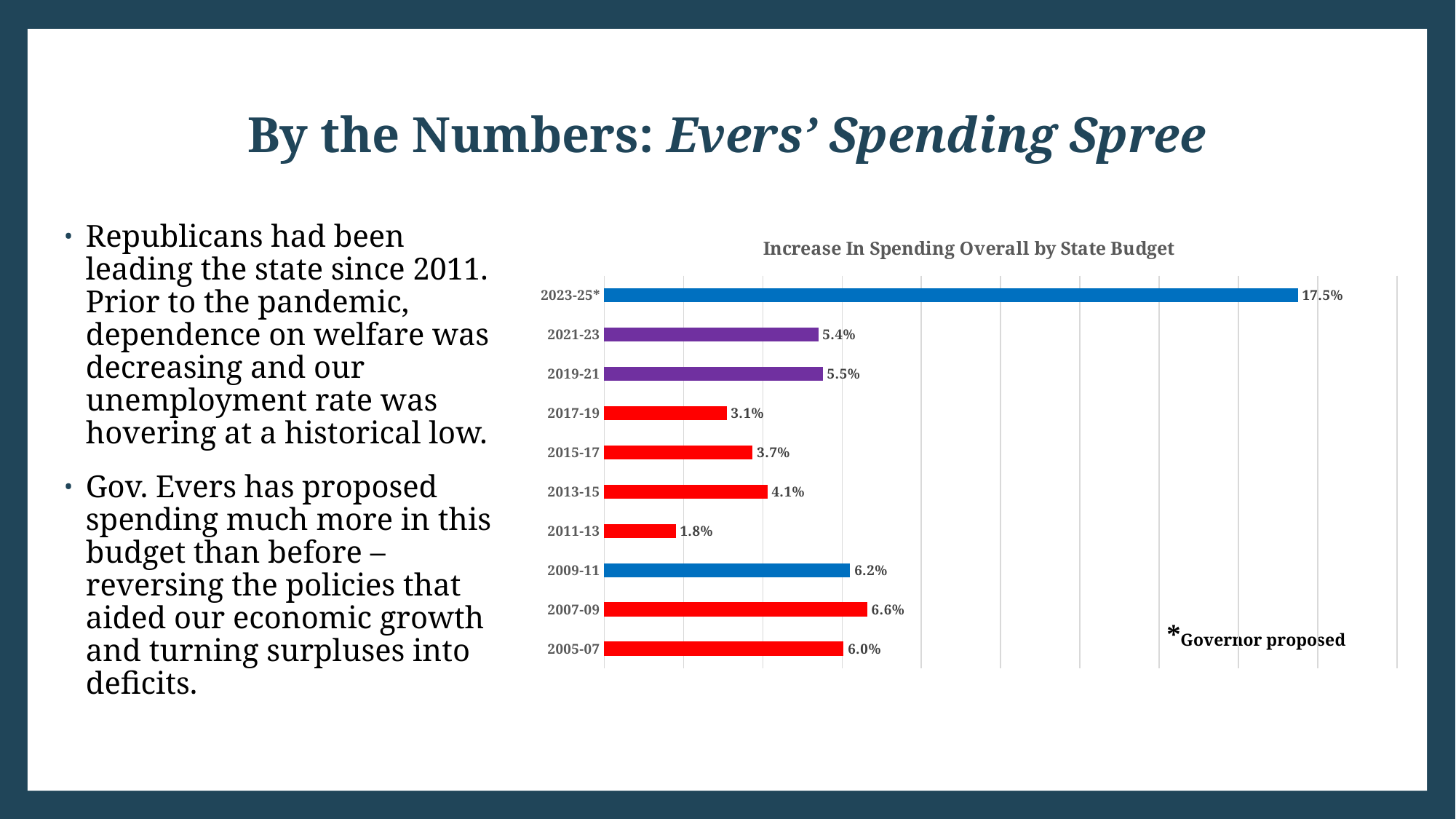
Which budget period had a larger increase in spending, 2013-15 or 2017-19? 2013-15 Which budget period has the highest increase in spending? 2023-25* Which budget period has the lowest increase in spending? 2011-13 What is the increase in spending for the 2011-13 budget? 1.8% What is the title of the chart? Increase In Spending Overall by State Budget How many budget periods are shown in the chart? 10 What kind of chart is shown on the slide? Bar chart What is the increase in spending for the 2007-09 budget? 6.6% What is the difference between the 2009-11 increase and the 2005-07 increase? 0.2% What does the asterisk next to 2023-25 indicate, according to the chart note? Governor proposed What is the difference between the 2023-25* increase and the 2021-23 increase? 12.1% What is the increase in spending for the 2023-25* budget? 17.5%